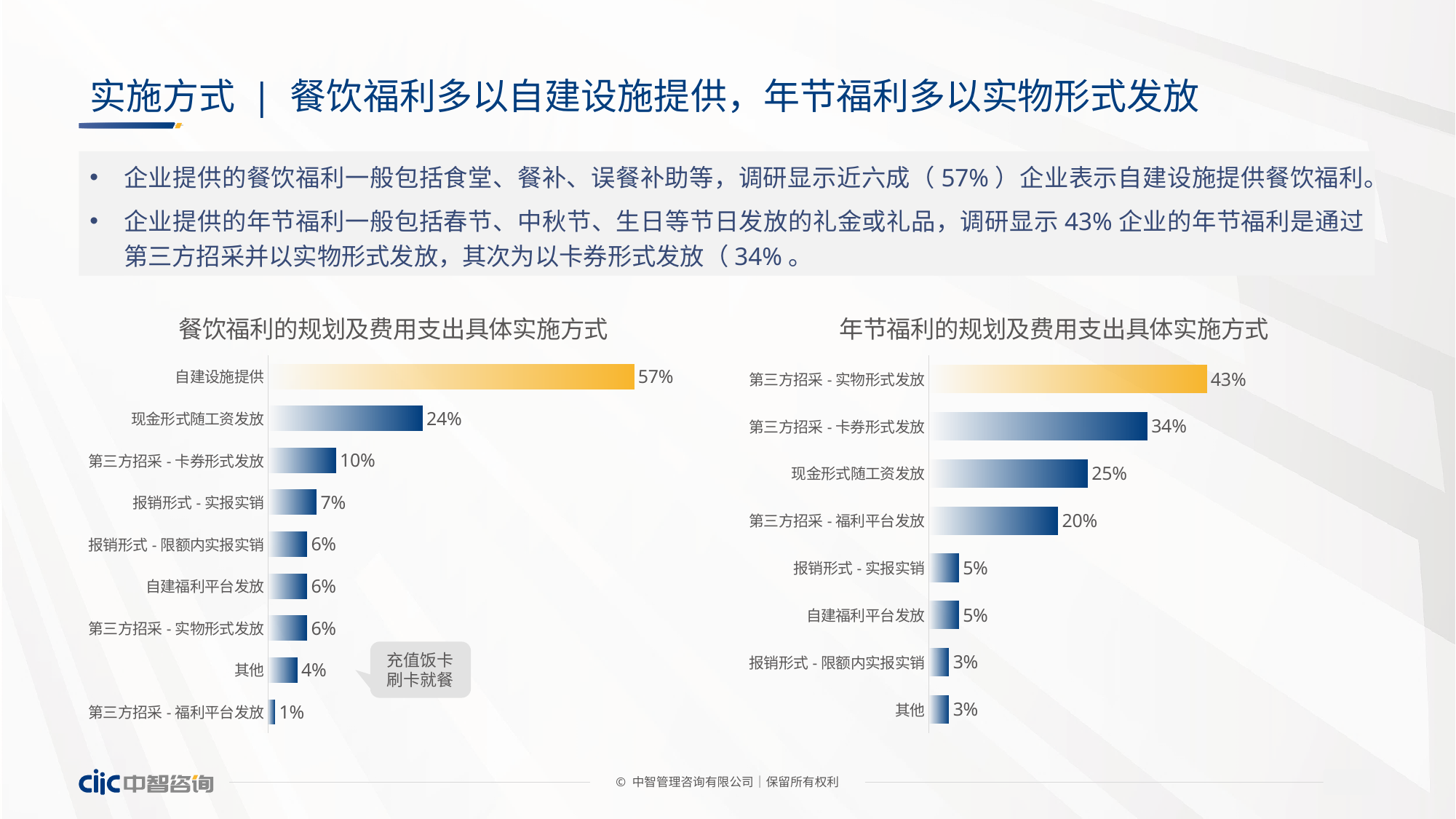
In the right chart (年节福利的规划及费用支出具体实施方式), which is larger: 第三方招采 - 卡券形式发放 or 现金形式随工资发放? 第三方招采 - 卡券形式发放 In the right chart (年节福利的规划及费用支出具体实施方式), what is the difference between 第三方招采 - 实物形式发放 and 第三方招采 - 卡券形式发放? 9% In the left chart (餐饮福利的规划及费用支出具体实施方式), which category has the lowest value? 第三方招采 - 福利平台发放 In the left chart (餐饮福利的规划及费用支出具体实施方式), what is the difference between 自建设施提供 and 现金形式随工资发放? 33% In the right chart (年节福利的规划及费用支出具体实施方式), what is the value for 第三方招采 - 实物形式发放? 43% In the right chart (年节福利的规划及费用支出具体实施方式), what is the value for 第三方招采 - 福利平台发放? 20% In the left chart (餐饮福利的规划及费用支出具体实施方式), what is the value for 现金形式随工资发放? 24% In the left chart (餐饮福利的规划及费用支出具体实施方式), what is the value for 自建设施提供? 57% In the right chart (年节福利的规划及费用支出具体实施方式), which category has the highest value? 第三方招采 - 实物形式发放 In the left chart (餐饮福利的规划及费用支出具体实施方式), how many categories are shown? 9 What type of chart is the left chart (餐饮福利的规划及费用支出具体实施方式)? Bar chart In the right chart (年节福利的规划及费用支出具体实施方式), how many categories are shown? 8